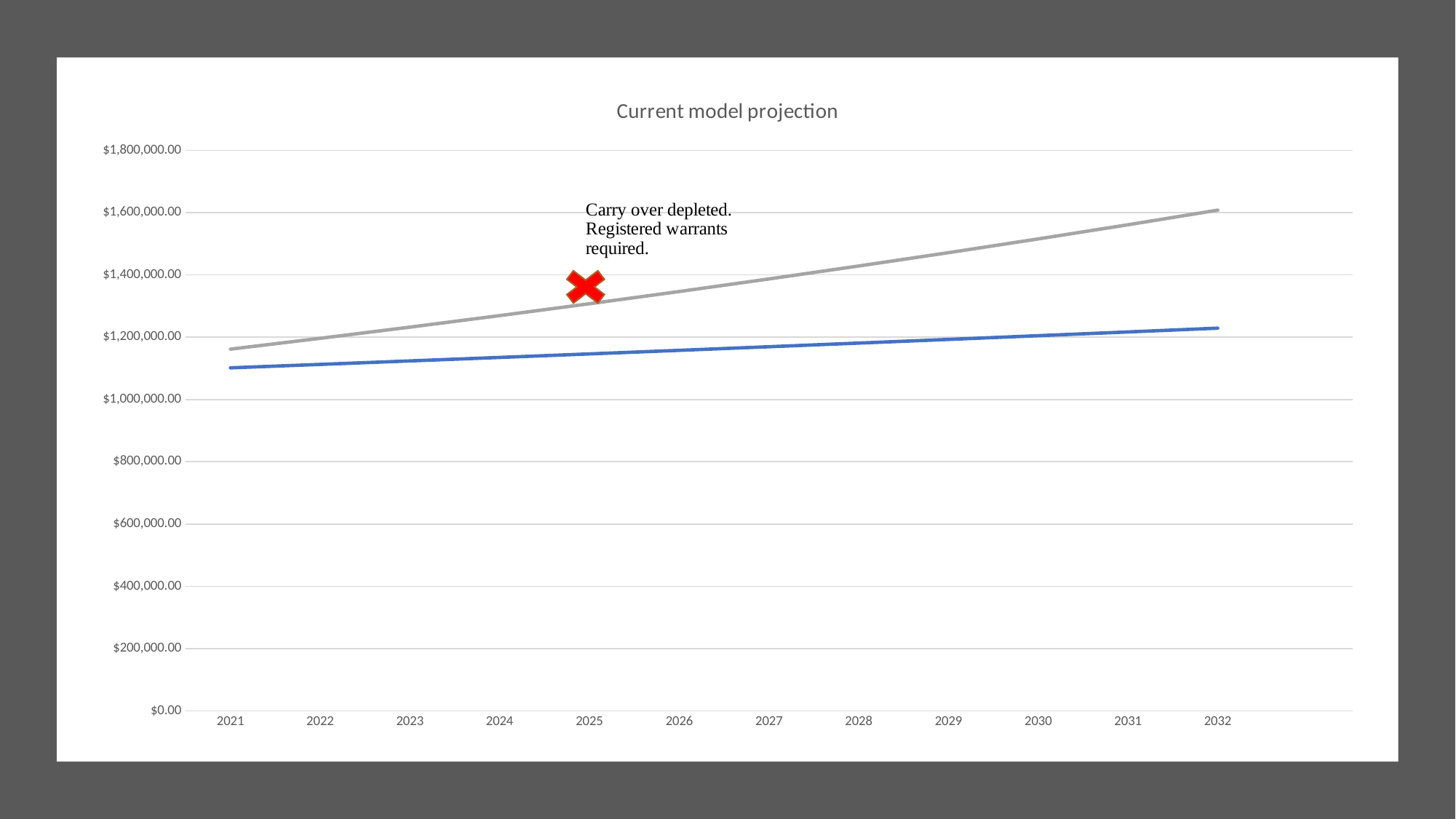
Above which year on the x axis is the red X marker placed? 2025 Do the values of the gray line rise or fall from 2021 to 2032? rise Is the value of the blue line in 2021 greater or less than $1,000,000.00? greater What is the title of the chart? Current model projection Is the value of the gray line in 2032 greater or less than $1,400,000.00? greater Is the value of the gray line in 2021 greater or less than $1,200,000.00? less What kind of chart is shown on the slide? line chart In 2032, which line has the higher value, the gray line or the blue line? the gray line Do the values of the blue line rise or fall from 2021 to 2032? rise How many lines are plotted on the chart? 2 How many years are shown on the x axis of the chart? 12